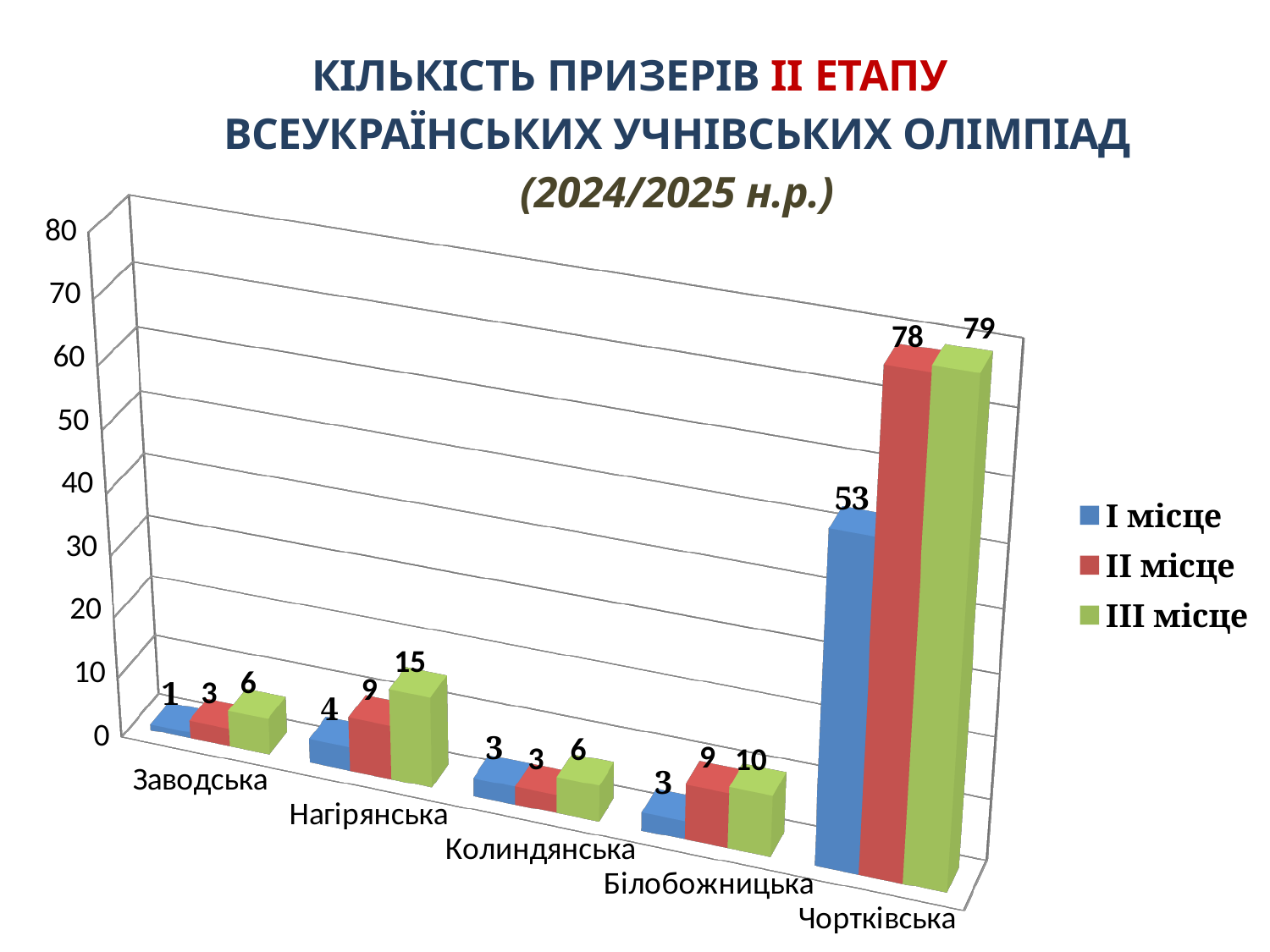
What is the value for I місце for Чортківська? 53 What is the value for III місце for Нагірянська? 15 Which colour represents II місце in the legend? red How many categories are shown on the x axis? 5 Which category has the highest value for III місце? Чортківська Which is larger for Нагірянська: the II місце value or the III місце value? III місце How many series does the legend list? 3 What is the total of the three values for Заводська? 10 What is the value for II місце for Білобожницька? 9 What is the difference between the II місце and I місце values for Чортківська? 25 Which category has the lowest value for I місце? Заводська What type of chart is shown on the slide? bar chart